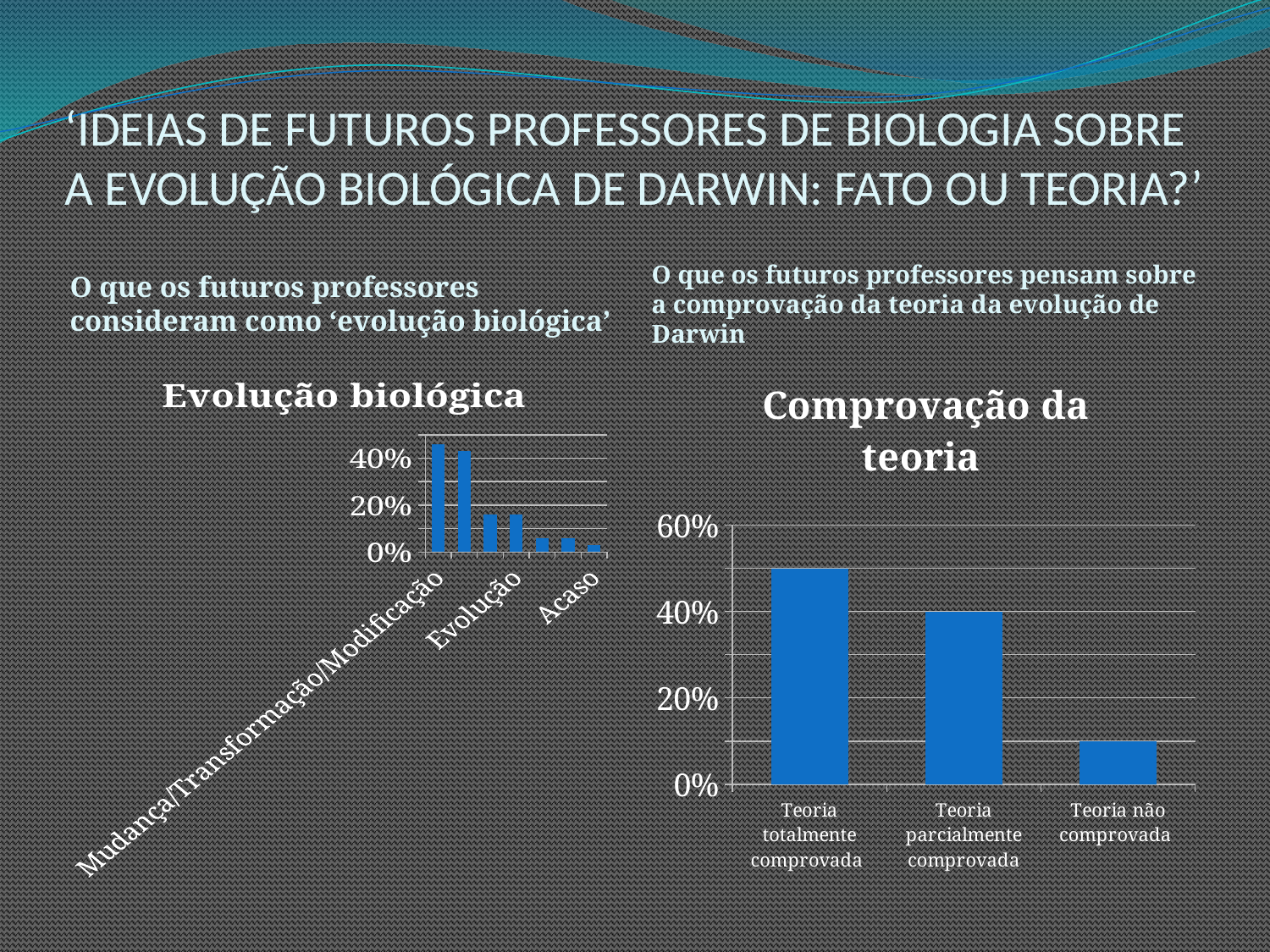
What kind of chart is the 'Comprovação da teoria' chart on the right? bar chart In the 'Comprovação da teoria' chart, which category has the lowest value? Teoria não comprovada In the 'Evolução biológica' chart, is the value for 'Acaso' greater or less than 20%? less In the 'Comprovação da teoria' chart, do the values rise or fall from left to right? fall In the 'Comprovação da teoria' chart, is the value for 'Teoria totalmente comprovada' greater or less than 40%? greater How many categories are shown in the 'Comprovação da teoria' chart? 3 In the 'Comprovação da teoria' chart, which category has the highest value? Teoria totalmente comprovada In the 'Comprovação da teoria' chart, is the value for 'Teoria não comprovada' greater or less than 20%? less In the 'Comprovação da teoria' chart, which is larger: 'Teoria totalmente comprovada' or 'Teoria parcialmente comprovada'? Teoria totalmente comprovada In the 'Comprovação da teoria' chart, what is the value for 'Teoria parcialmente comprovada'? 40% What is the highest tick label on the vertical axis of the 'Comprovação da teoria' chart? 60% How many bars are plotted in the 'Evolução biológica' chart on the left? 7